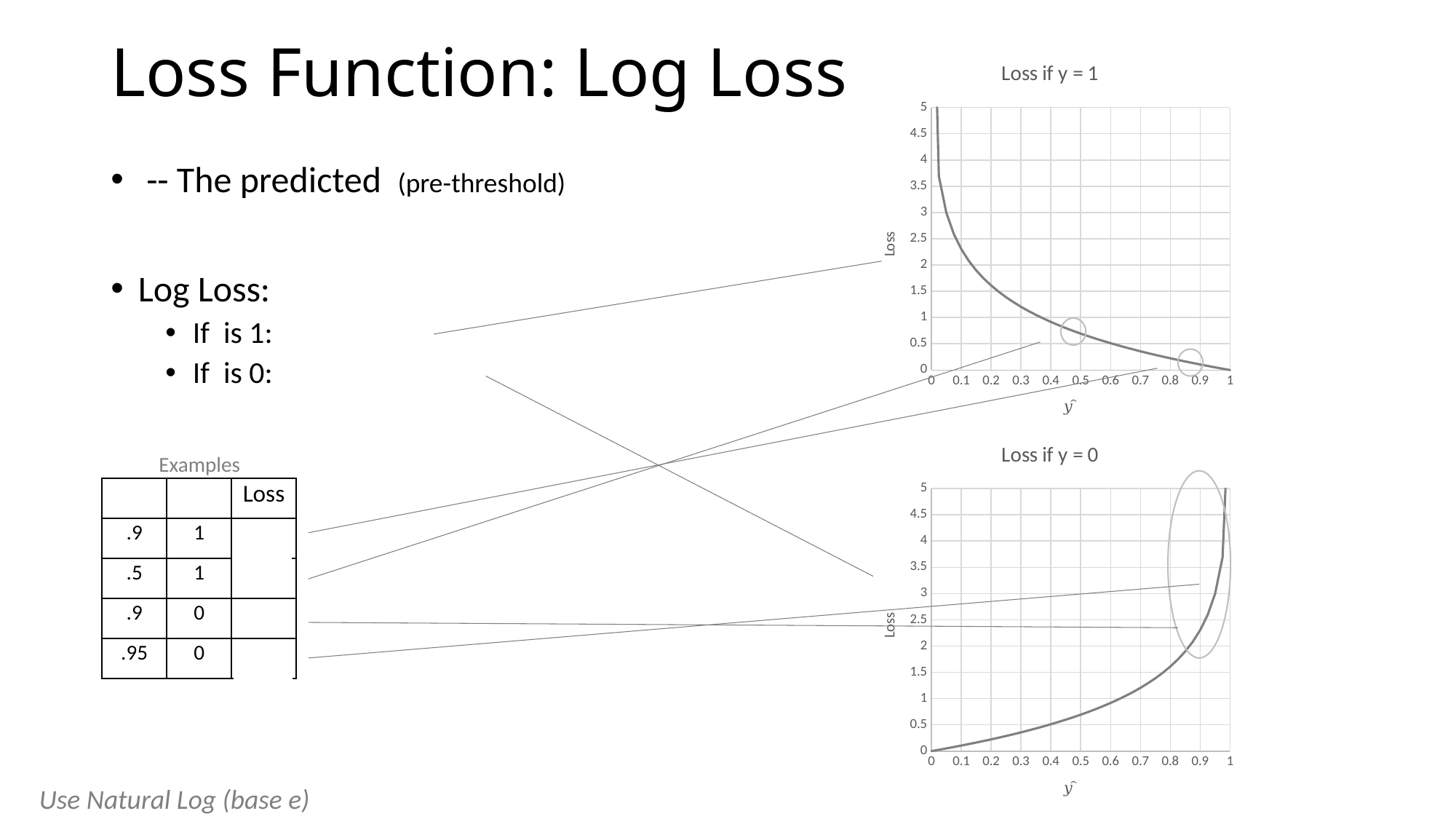
In the "Loss if y = 0" chart, is the loss at ŷ = 0.1 greater or less than 0.5? less In the "Loss if y = 0" chart, is the loss at ŷ = 0.9 greater or less than 2? greater What is the highest tick value shown on the vertical axis of the "Loss if y = 0" chart? 5 In the "Loss if y = 1" chart, is the loss at ŷ = 0.9 greater or less than 0.5? less In the "Loss if y = 0" chart, does the loss rise or fall as ŷ increases from 0 to 1? rise What is the label of the vertical axis on the "Loss if y = 1" chart? Loss In the "Loss if y = 1" chart, does the loss rise or fall as ŷ increases from 0 to 1? fall What kind of chart is the "Loss if y = 0" chart? line chart What kind of chart is the "Loss if y = 1" chart? line chart